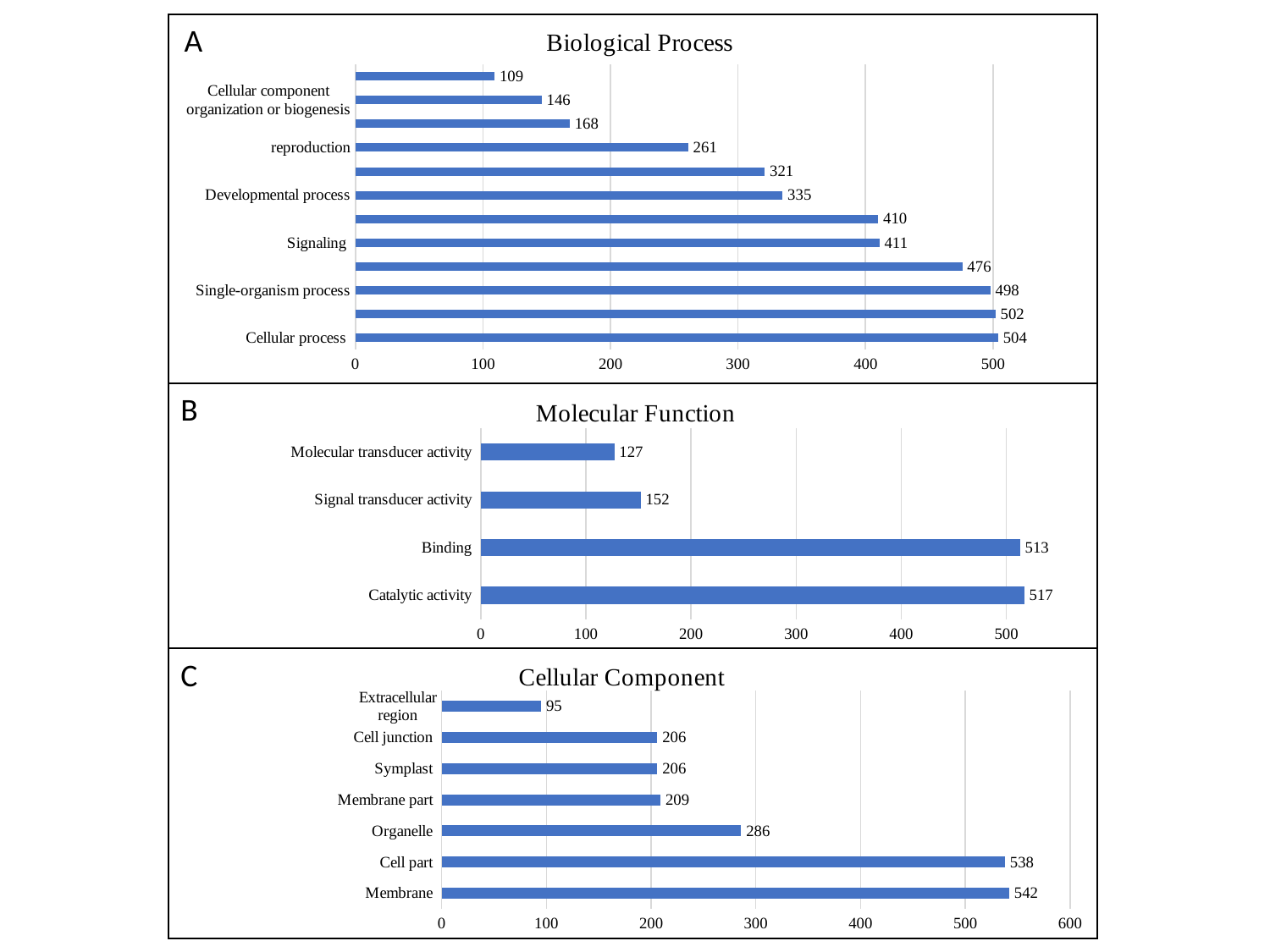
In the Molecular Function chart, what is the difference between Signal transducer activity and Molecular transducer activity? 25 In the Cellular Component chart, what is the value for Organelle? 286 In the Cellular Component chart, which category has the lowest value? Extracellular region In the Cellular Component chart, what is the difference between Membrane and Cell part? 4 In the Molecular Function chart, how many categories are plotted? 4 In the Biological Process chart, which is larger, Developmental process or reproduction? Developmental process In the Biological Process chart, what is the value for Signaling? 411 What type of chart is the Biological Process chart? Bar chart In the Cellular Component chart, how many categories are plotted? 7 In the Molecular Function chart, which category has the highest value? Catalytic activity In the Molecular Function chart, what is the value for Binding? 513 In the Molecular Function chart, which category has the lowest value? Molecular transducer activity